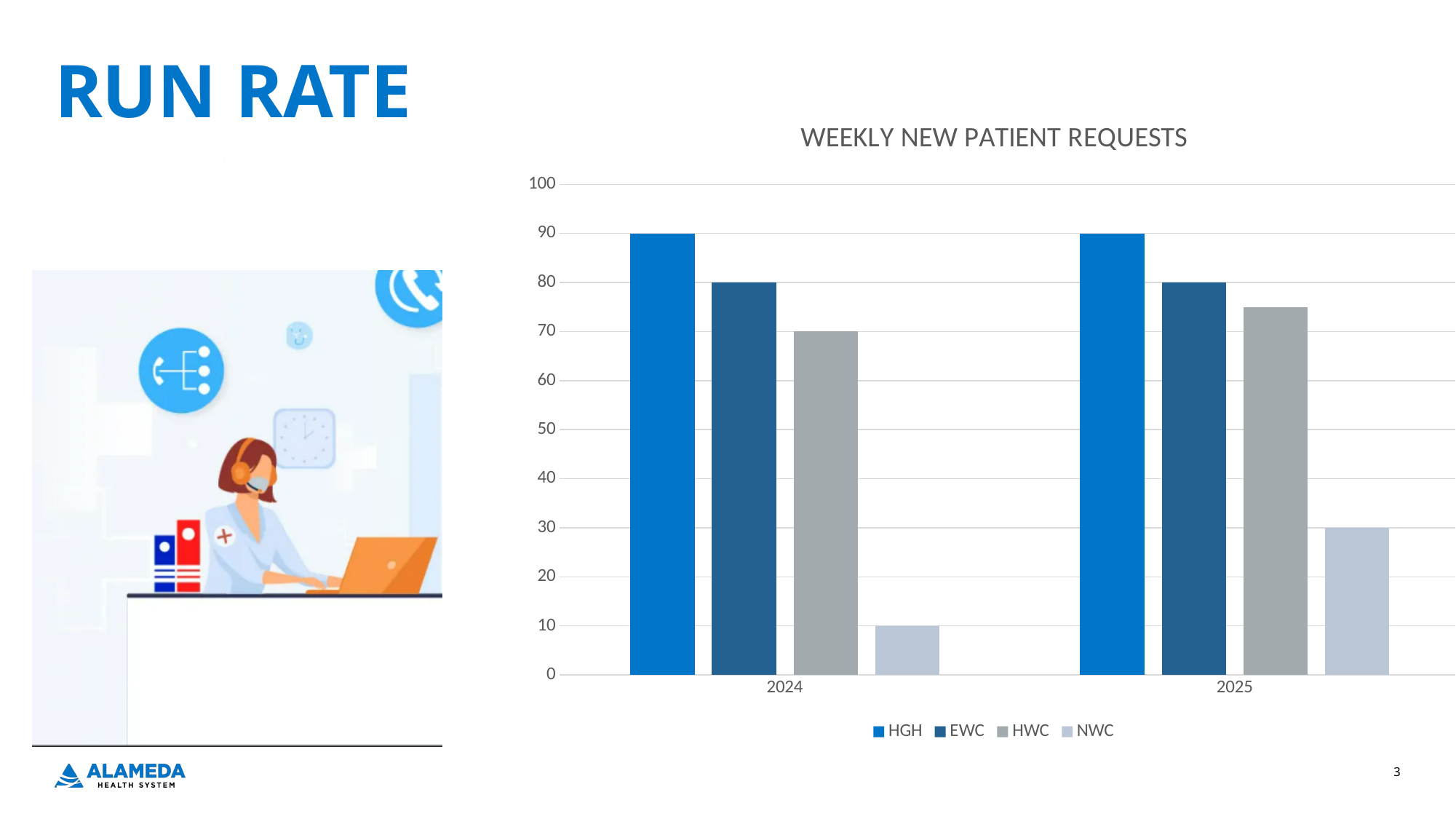
What kind of chart is shown on the slide? bar chart How many year categories are shown on the x axis? 2 Is the value for HWC in 2025 greater or less than 70? greater How many series does the legend list? 4 Which series has the highest value in 2025? HGH What is the value for EWC in 2025? 80 What is the value for HGH in 2024? 90 Which series has the lowest value in 2024? NWC What is the value for NWC in 2025? 30 What is the difference between the NWC values for 2025 and 2024? 20 What is the value for NWC in 2024? 10 What is the title of the chart? WEEKLY NEW PATIENT REQUESTS